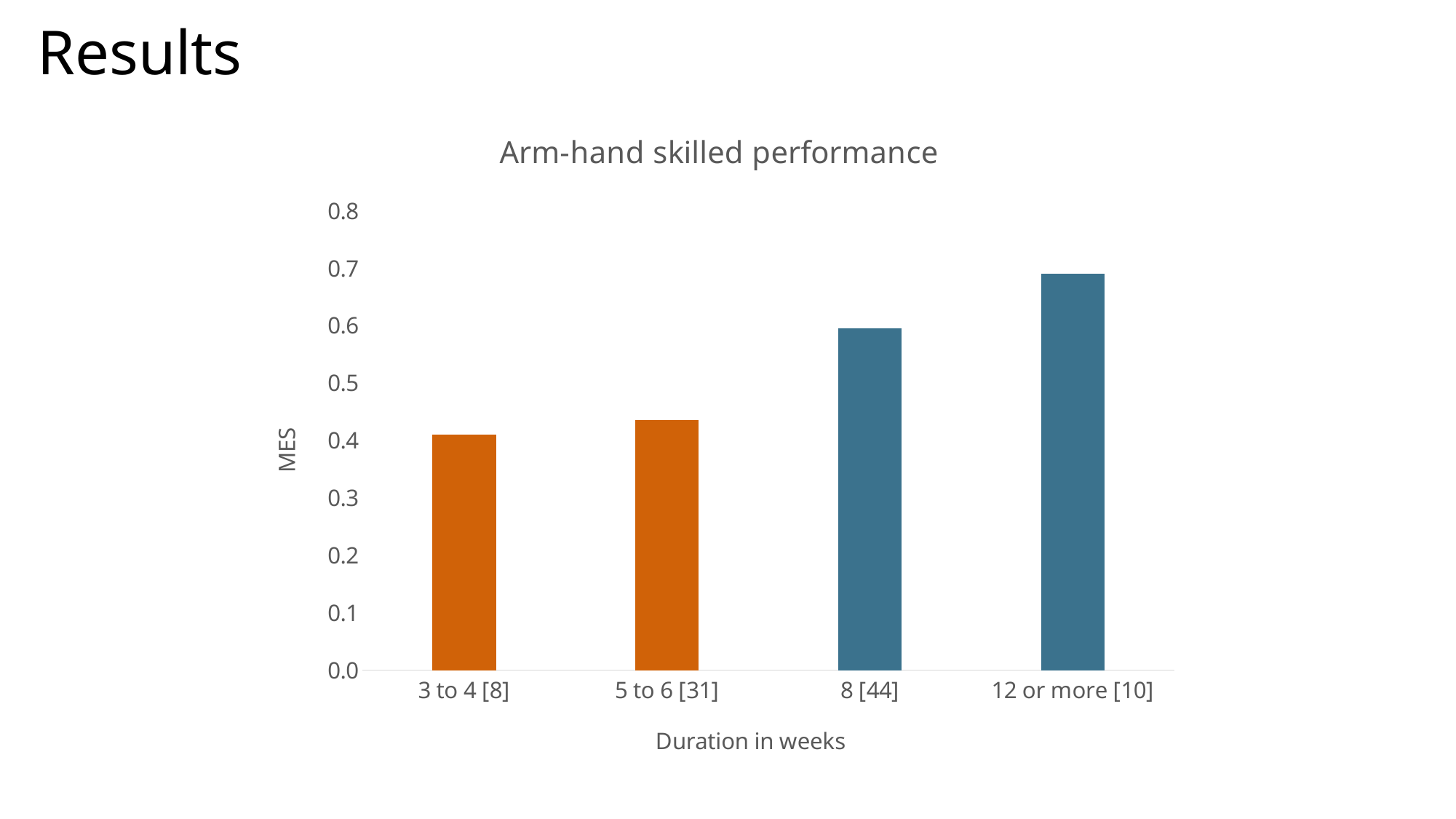
Is the MES value for 5 to 6 [31] greater or less than 0.4? greater Is the MES value for 8 [44] greater or less than 0.7? less Is the MES value for 3 to 4 [8] greater or less than 0.5? less What is the title of the chart? Arm-hand skilled performance What is the label of the y axis? MES What kind of chart is shown on the slide? bar chart Do the MES values rise or fall as duration in weeks increases along the x axis? rise Which duration category has the lowest MES value? 3 to 4 [8] How many duration categories are shown on the x axis? 4 Which has a larger MES value, 8 [44] or 5 to 6 [31]? 8 [44] Which duration category has the highest MES value? 12 or more [10]